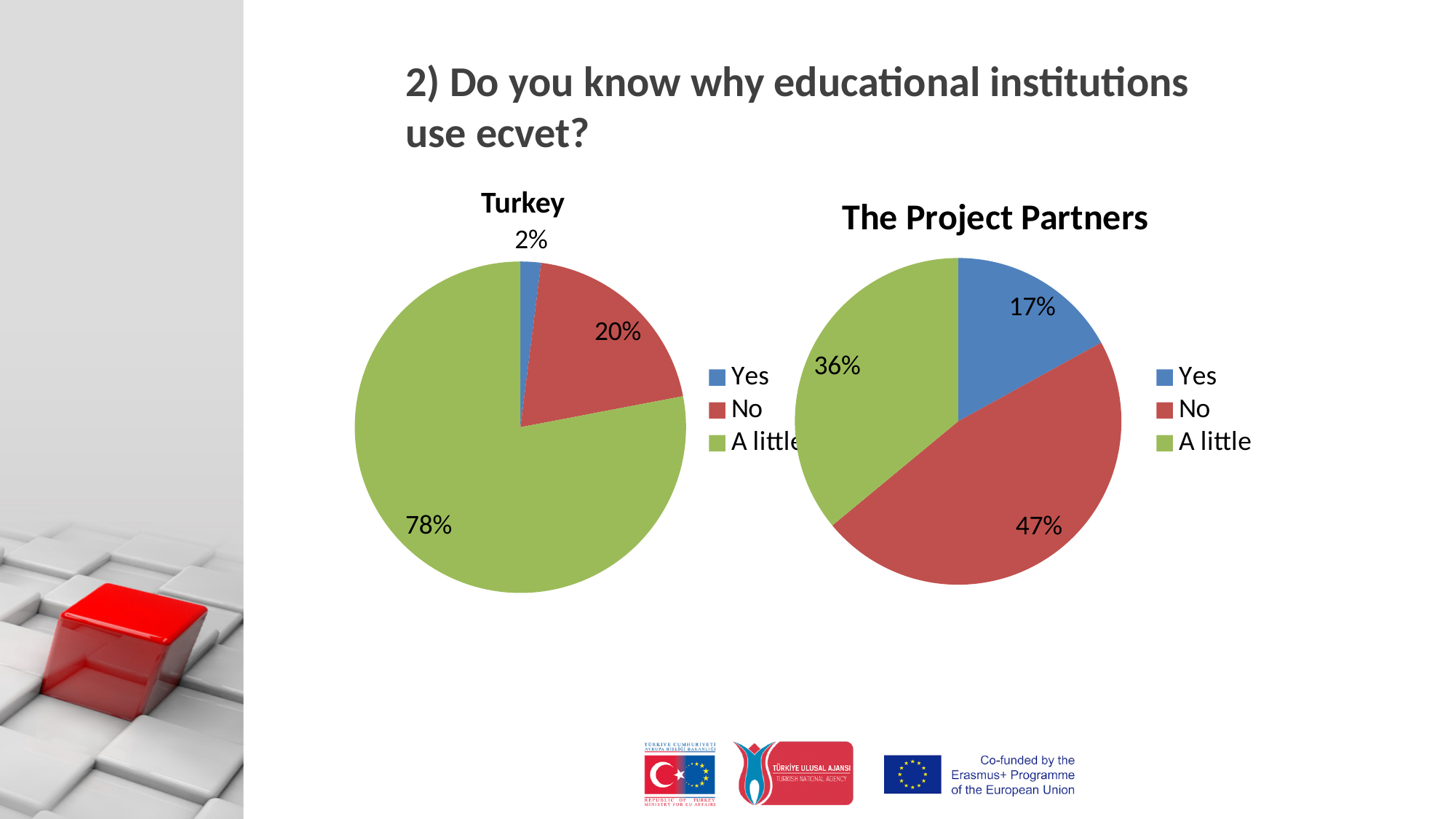
In The Project Partners chart, what share of respondents answered "Yes"? 17% In The Project Partners chart, what is the difference between the "No" and "A little" shares? 11% In the Turkey chart, what share of respondents answered "No"? 20% In The Project Partners chart, what share of respondents answered "No"? 47% In the Turkey chart, what share of respondents answered "Yes"? 2% Which is larger in the Turkey chart: the "No" share or the "Yes" share? No In The Project Partners chart, which answer has the largest slice? No How many categories does the legend of The Project Partners chart list? 3 In The Project Partners chart, which colour represents "A little"? Green In the Turkey chart, which answer has the smallest slice? Yes What type of chart is the Turkey chart? Pie chart In the Turkey chart, what share of respondents answered "A little"? 78%